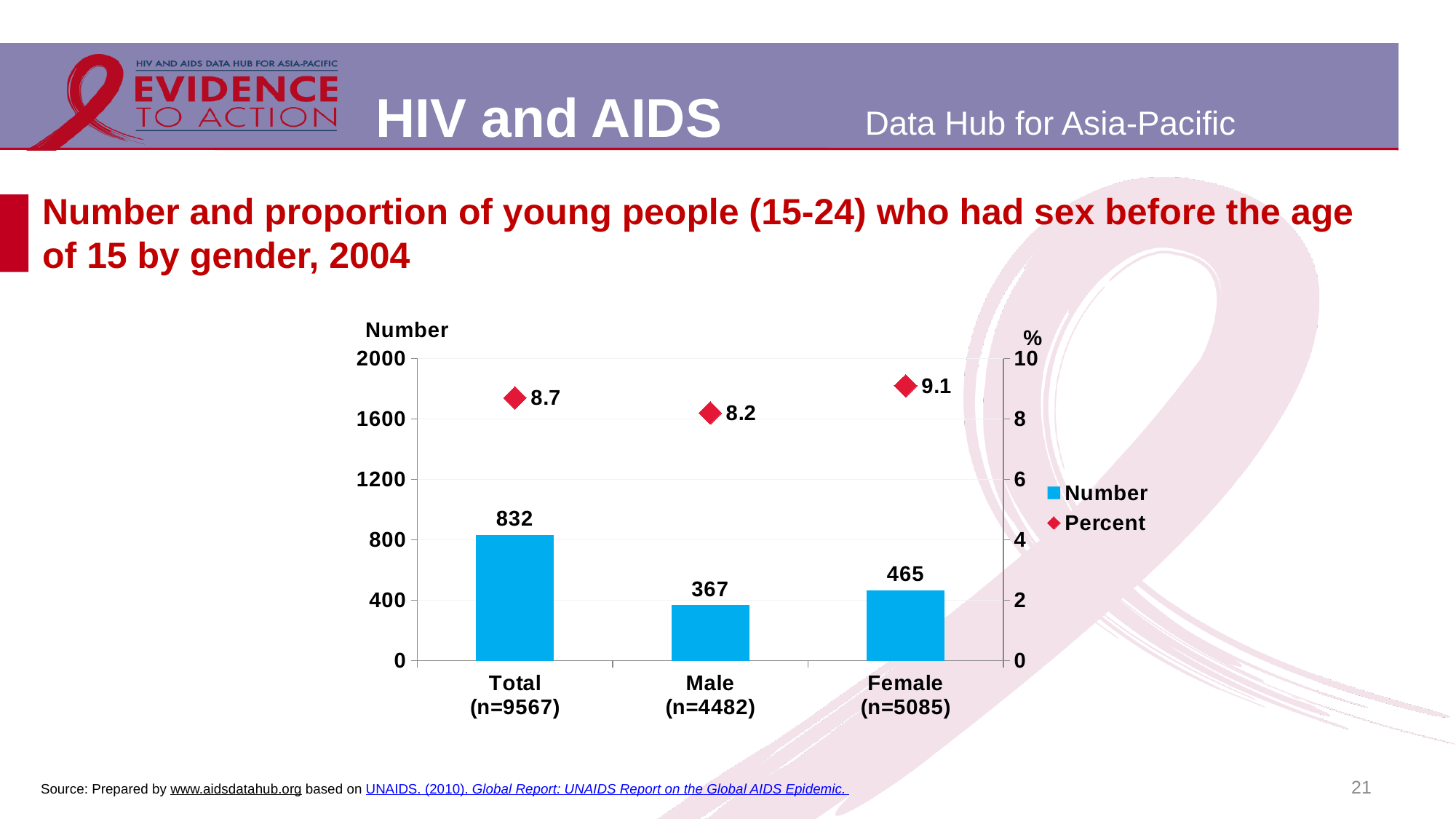
What is the Number value for Male (n=4482)? 367 Is the Number value for Total (n=9567) greater or less than 800? greater Which category has the lowest Number value? Male (n=4482) What is the difference between the Number values for Female (n=5085) and Male (n=4482)? 98 How many series does the legend list? 2 What is the Number value for Total (n=9567)? 832 How many categories are shown on the x axis? 3 What is the Percent value for Female (n=5085)? 9.1 Which category has the highest Percent value? Female (n=5085) What is the Percent value for Male (n=4482)? 8.2 Which is larger, the Percent value for Total (n=9567) or for Male (n=4482)? Total (n=9567) What is the label of the right-hand vertical axis? %